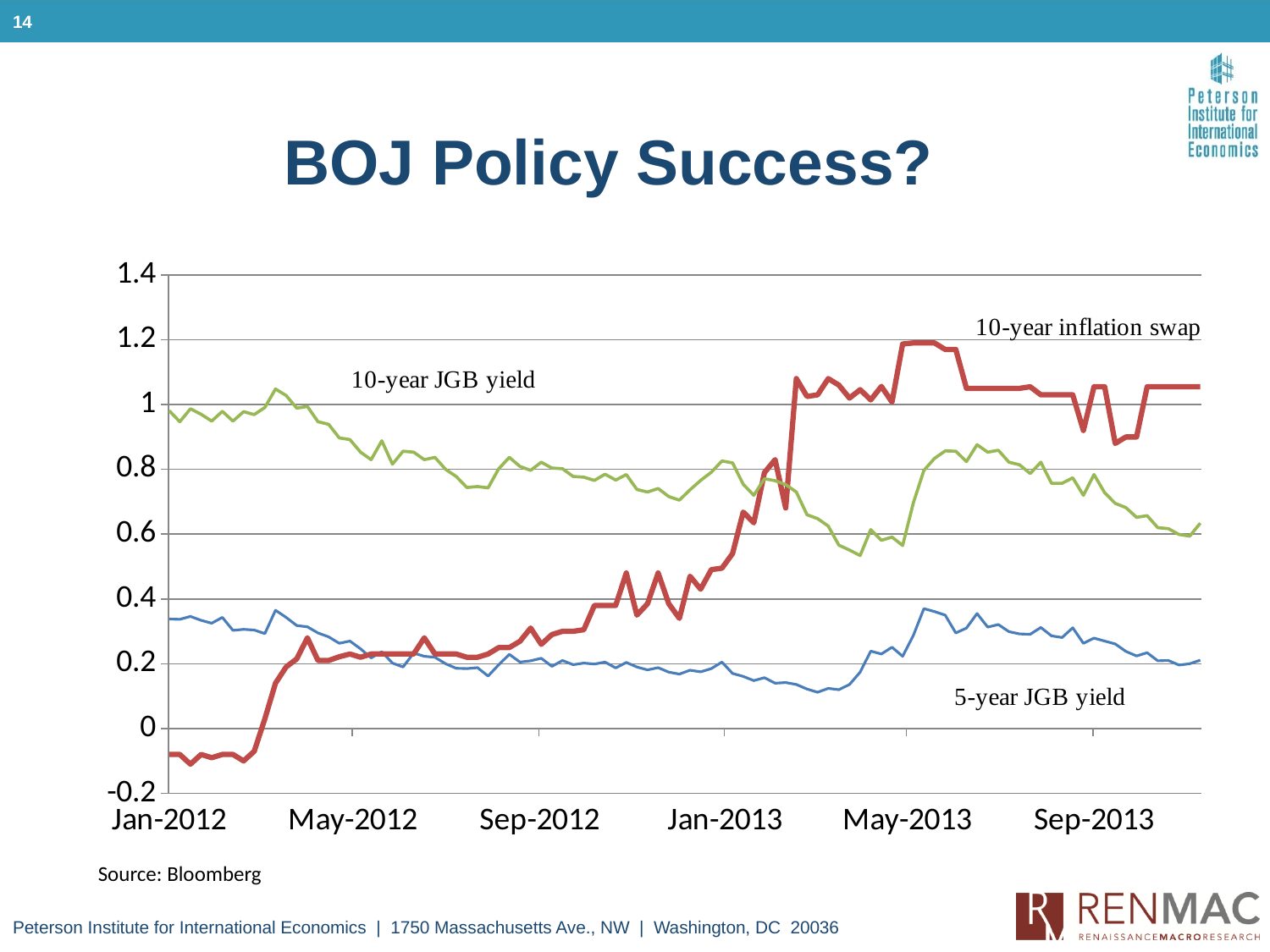
Does the 10-year JGB yield rise or fall overall from Jan-2012 to Sep-2013? fall How many series are plotted on the chart? 3 Is the value of the 5-year JGB yield at Jan-2013 greater or less than 0.4? less What kind of chart is shown on the slide? line chart What source is cited for the chart data? Bloomberg What is the title of the slide containing the chart? BOJ Policy Success? Is the value of the 10-year inflation swap at Jan-2012 greater or less than 0? less At Jan-2012, which is higher: the 10-year JGB yield or the 10-year inflation swap? 10-year JGB yield Is the value of the 10-year JGB yield at Jan-2012 greater or less than 0.8? greater Does the 10-year inflation swap rise or fall overall from Jan-2012 to Sep-2013? rise Which series has the lowest value at Sep-2013? 5-year JGB yield